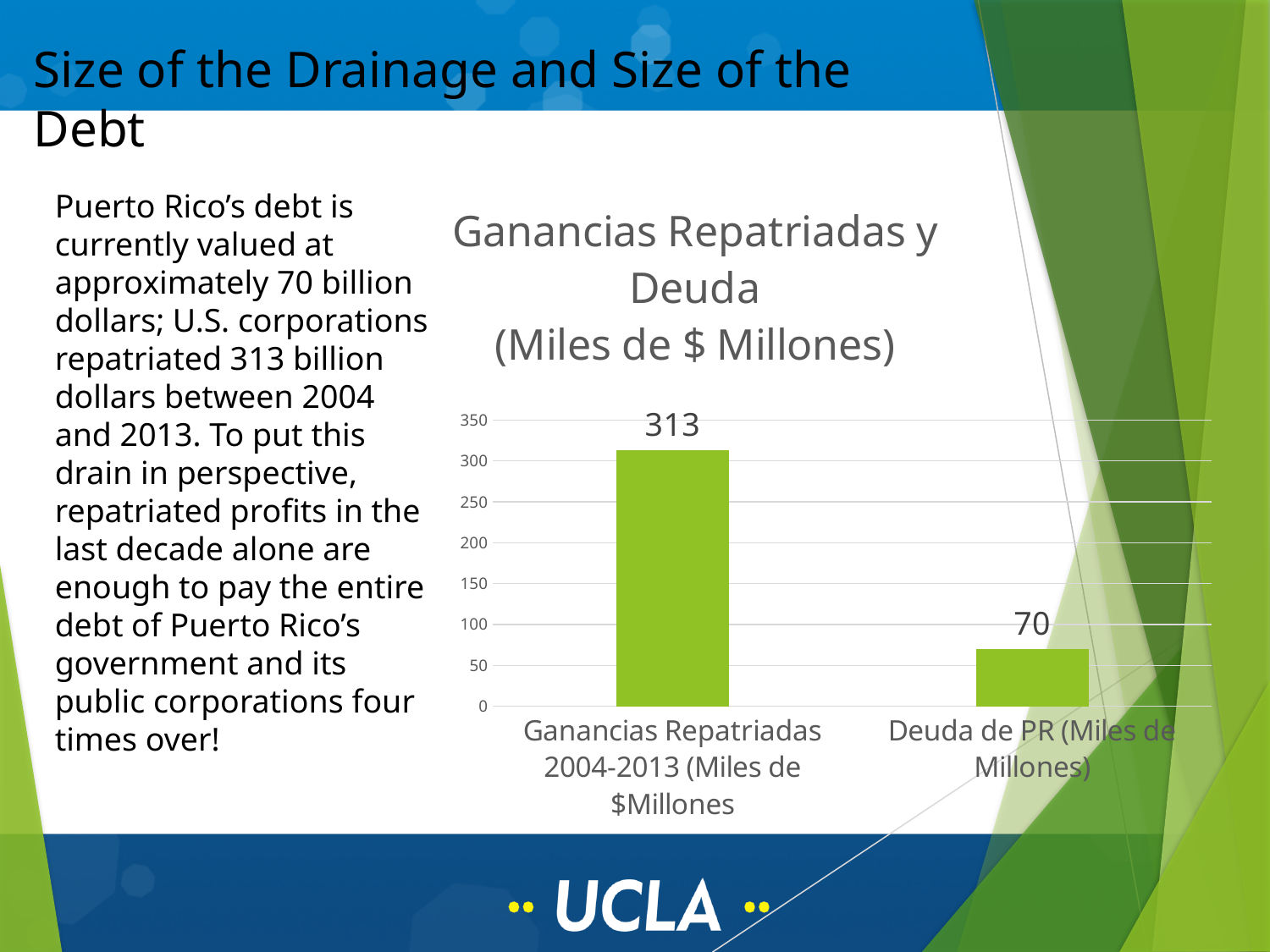
Is the value for Ganancias Repatriadas 2004-2013 greater or less than 300? greater What is the value for Ganancias Repatriadas 2004-2013 (Miles de $Millones)? 313 What is the title of the chart? Ganancias Repatriadas y Deuda (Miles de $ Millones) Which category has the highest value? Ganancias Repatriadas 2004-2013 (Miles de $Millones) How many categories are shown in the chart? 2 What kind of chart is shown on the slide? Bar chart Is the value for Deuda de PR greater or less than 100? less Which category has the lowest value? Deuda de PR (Miles de Millones) Which is larger, the value for Ganancias Repatriadas 2004-2013 or the value for Deuda de PR? Ganancias Repatriadas 2004-2013 What is the value for Deuda de PR (Miles de Millones)? 70 What is the highest value shown on the chart's vertical axis? 350 What is the difference between the value for Ganancias Repatriadas 2004-2013 and the value for Deuda de PR? 243